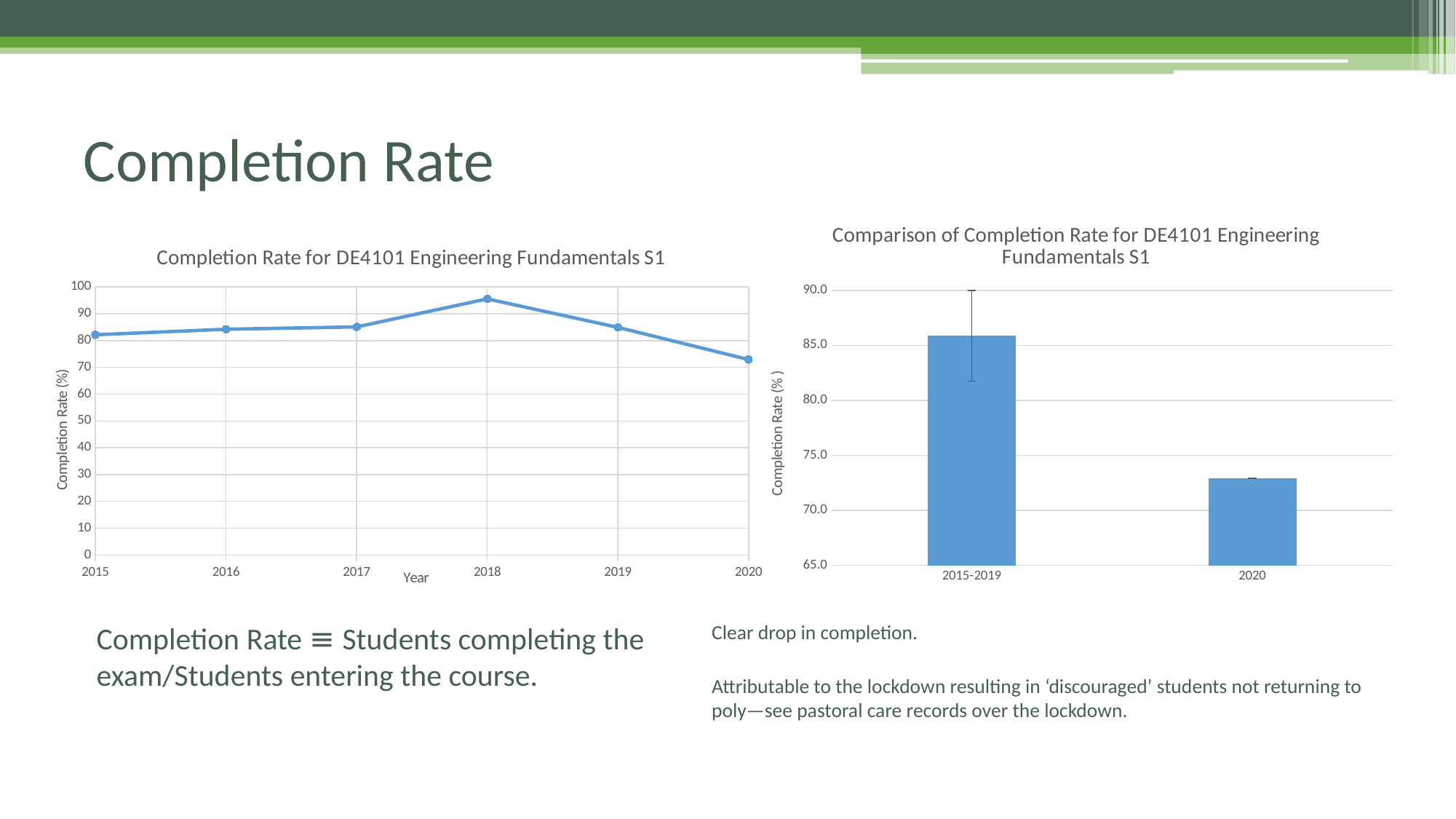
In the left line chart, how many years are plotted on the x axis? 6 What is the x-axis label of the left line chart? Year In the left line chart, is the completion rate for 2020 greater or less than 80? less What type of chart is the left chart titled 'Completion Rate for DE4101 Engineering Fundamentals S1'? line chart In the left line chart, which year has the lowest completion rate? 2020 In the right bar chart, is the completion rate for 2020 greater or less than 75.0? less In the right bar chart, which category has the higher completion rate, 2015-2019 or 2020? 2015-2019 In the left line chart, does the completion rate rise or fall between 2018 and 2020? fall What type of chart is the right chart titled 'Comparison of Completion Rate for DE4101 Engineering Fundamentals S1'? bar chart In the left line chart, is the completion rate for 2018 greater or less than 90? greater In the left line chart, which year has the highest completion rate? 2018